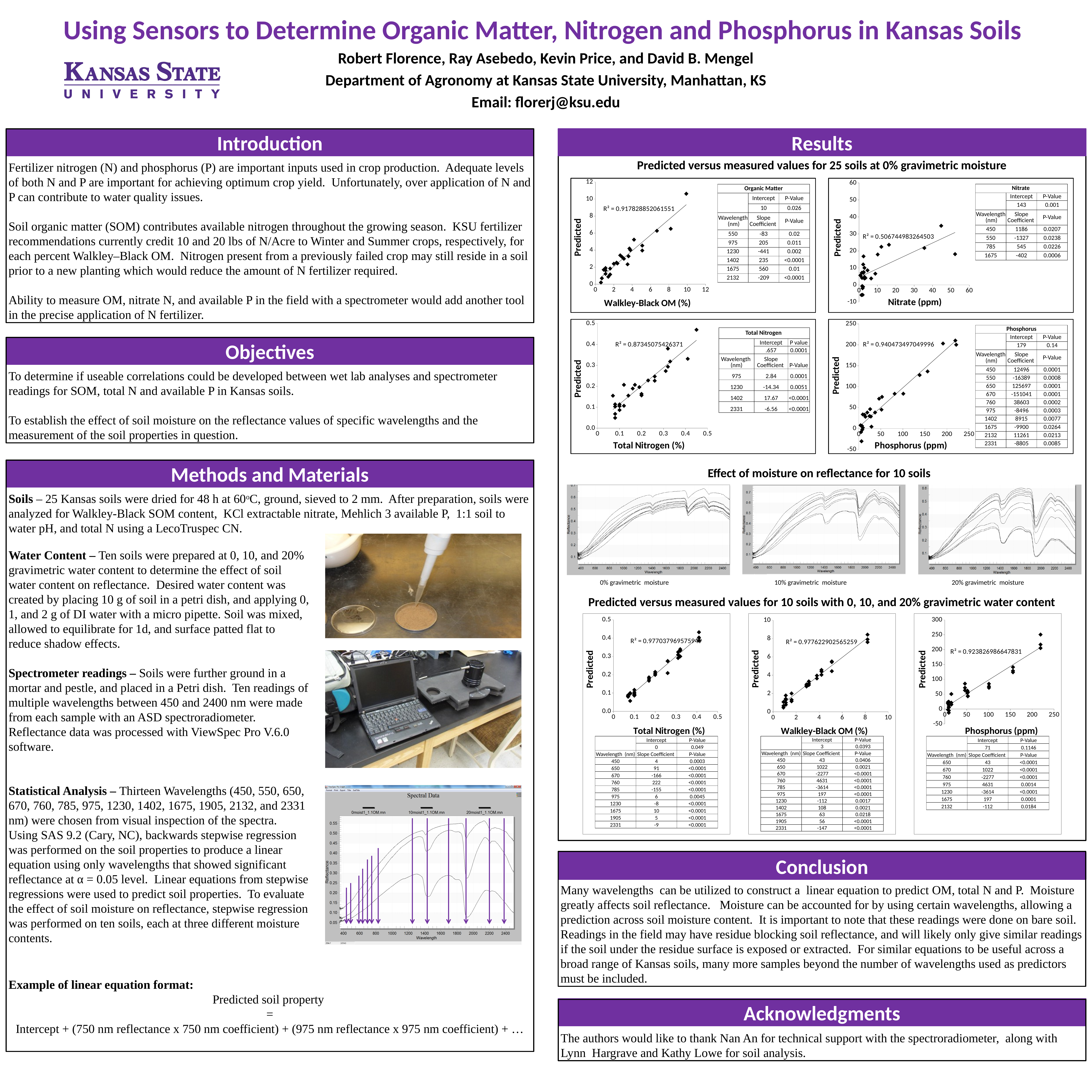
In the 'Predicted versus measured values for 10 soils with 0, 10, and 20% gravimetric water content' section, what R² value is printed on the Walkley-Black OM (%) chart? R² = 0.977622902565259 What kind of chart is the 'Walkley-Black OM (%)' chart under 'Predicted versus measured values for 25 soils at 0% gravimetric moisture'? scatter chart In the 'Predicted versus measured values for 25 soils at 0% gravimetric moisture' section, what R² value is printed on the Walkley-Black OM (%) chart? R² = 0.917828852061551 In the 'Predicted versus measured values for 10 soils with 0, 10, and 20% gravimetric water content' section, is the printed R² for Total Nitrogen (%) larger or smaller than the printed R² for Phosphorus (ppm)? larger What is the y-axis label on the Walkley-Black OM (%) chart for 25 soils at 0% gravimetric moisture? Predicted In the 'Predicted versus measured values for 25 soils at 0% gravimetric moisture' section, what R² value is printed on the Total Nitrogen (%) chart? R² = 0.87345075426371 Among the four charts under 'Predicted versus measured values for 25 soils at 0% gravimetric moisture', which soil property has the highest printed R² value? Phosphorus (ppm) In the 'Predicted versus measured values for 25 soils at 0% gravimetric moisture' section, what R² value is printed on the Nitrate (ppm) chart? R² = 0.506744983264503 In the 'Predicted versus measured values for 25 soils at 0% gravimetric moisture' section, what R² value is printed on the Phosphorus (ppm) chart? R² = 0.940473497049996 In the Nitrate (ppm) chart for 25 soils at 0% gravimetric moisture, is the highest predicted value greater or less than 30? greater In the 'Predicted versus measured values for 10 soils with 0, 10, and 20% gravimetric water content' section, what R² value is printed on the Phosphorus (ppm) chart? R² = 0.923826986647831 Among the four charts under 'Predicted versus measured values for 25 soils at 0% gravimetric moisture', which soil property has the lowest printed R² value? Nitrate (ppm)